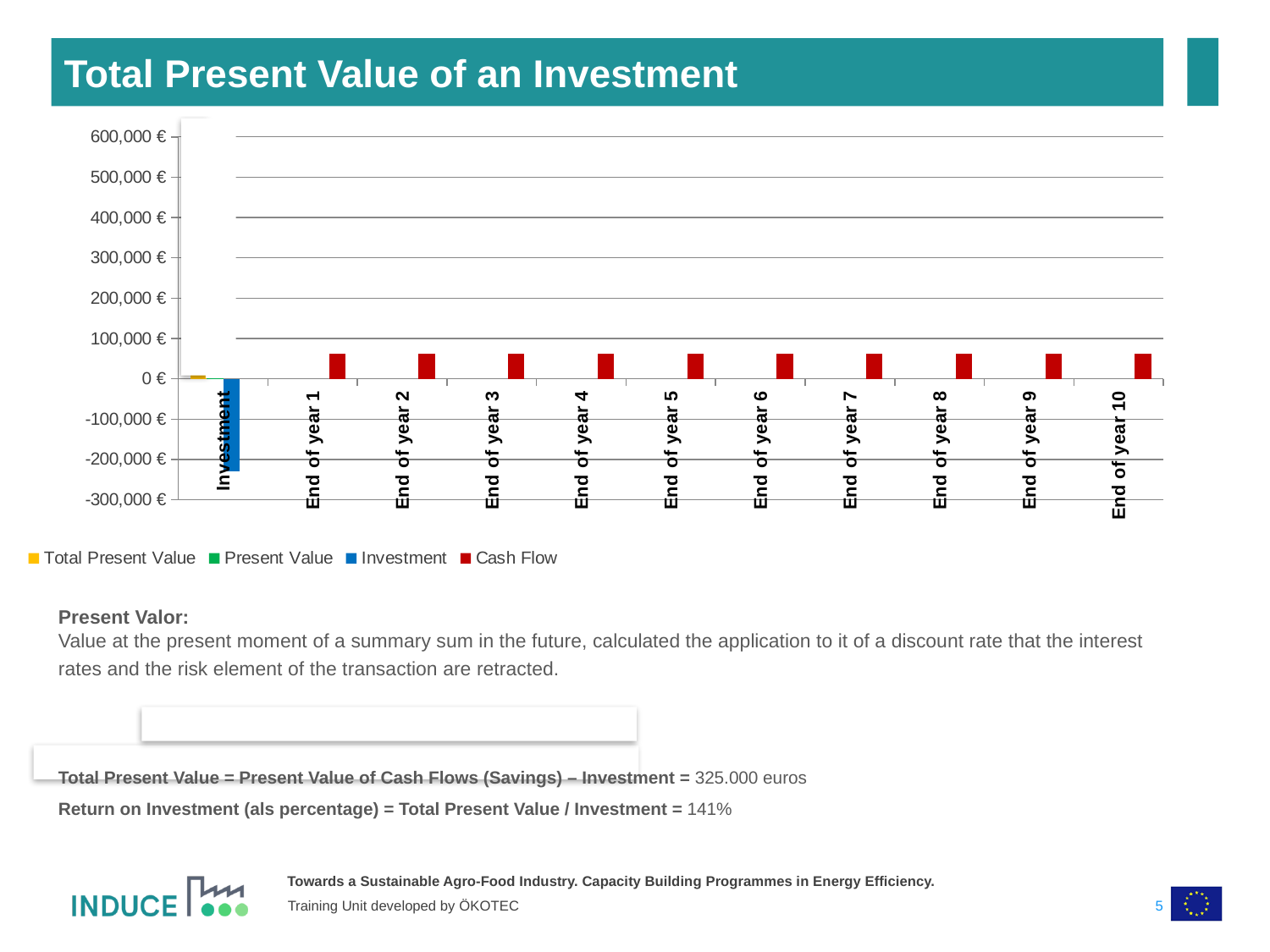
Is the Cash Flow value at End of year 1 greater or less than 100,000 €? less Do the Cash Flow bars rise, fall, or stay the same from End of year 1 to End of year 10? stay the same Is the value of the Investment bar greater or less than -200,000 €? less What is the title of the chart on the slide? Total Present Value of an Investment Which is larger: the Investment bar or the Cash Flow bar at End of year 5? Cash Flow at End of year 5 How many series does the chart legend list? 4 Which category has the lowest plotted value in the chart? Investment How many categories are shown along the x axis of the chart? 11 What kind of chart is shown on the slide? bar chart What colour represents the Cash Flow series in the legend? red Is the Cash Flow value at End of year 10 greater or less than 0 €? greater